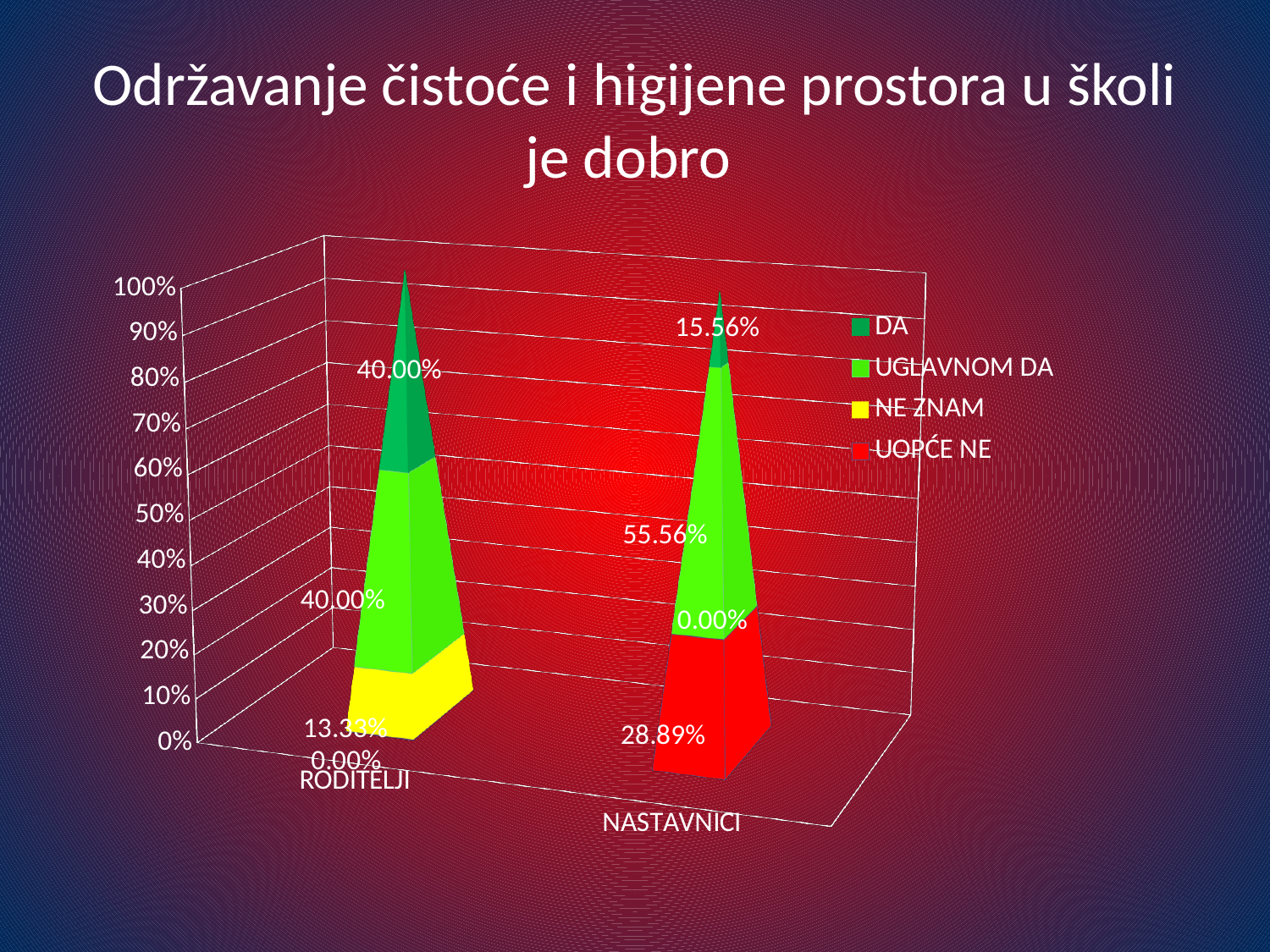
Which colour represents the UOPĆE NE series in the legend? Red What kind of chart is shown on the slide? Stacked bar chart What percentage of NASTAVNICI answered DA? 15.56% What percentage of RODITELJI answered UOPĆE NE? 0.00% Which group has the larger share of UOPĆE NE answers, RODITELJI or NASTAVNICI? NASTAVNICI What percentage of NASTAVNICI answered UOPĆE NE? 28.89% What is the difference between the UGLAVNOM DA share for NASTAVNICI and for RODITELJI? 15.56% What percentage of RODITELJI answered NE ZNAM? 13.33% What percentage of NASTAVNICI answered NE ZNAM? 0.00% How many series does the legend list? 4 What percentage of NASTAVNICI answered UGLAVNOM DA? 55.56% How many categories are shown on the x axis? 2